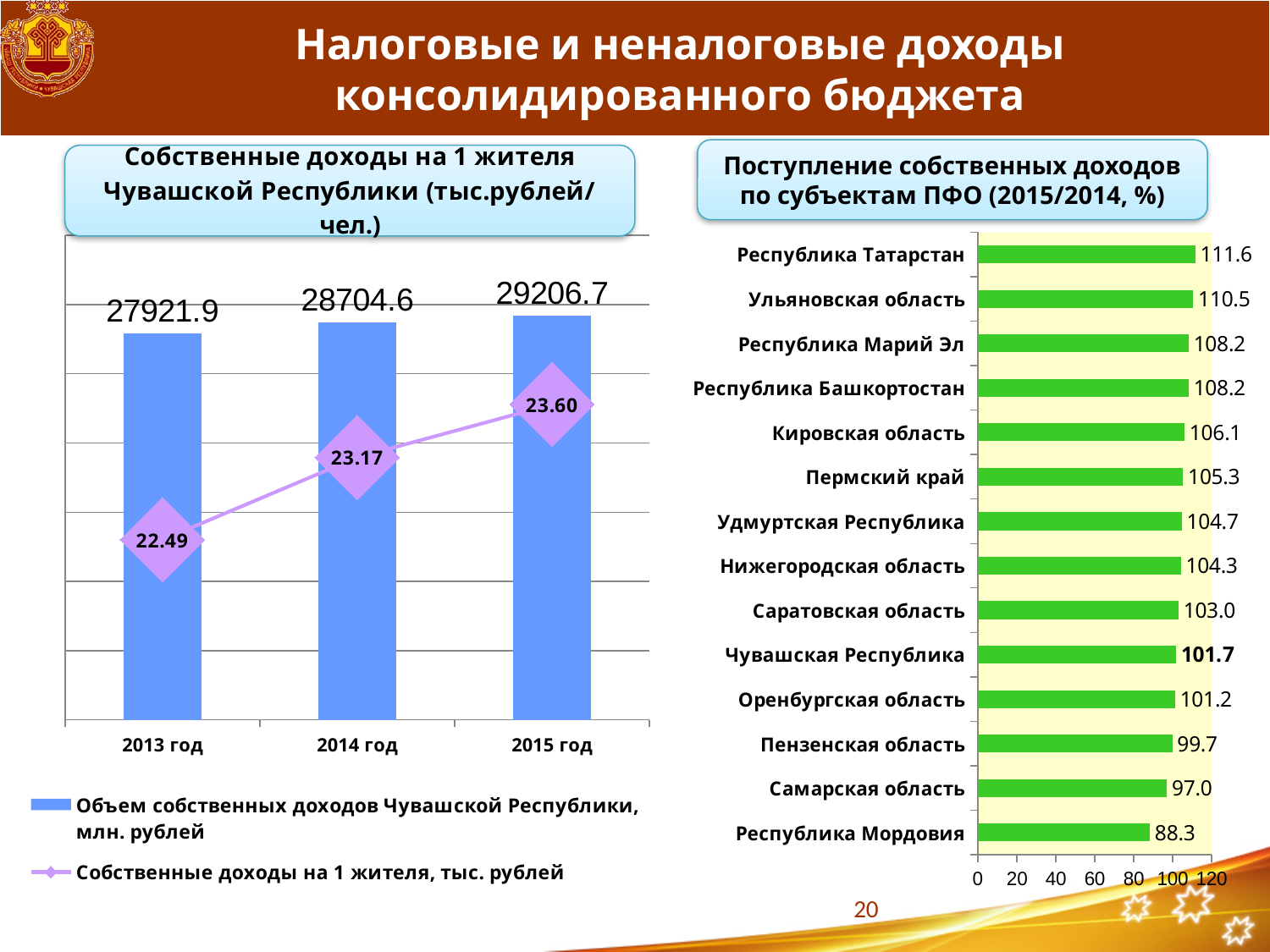
In the right chart (Поступление собственных доходов по субъектам ПФО), which region has the highest value? Республика Татарстан In the right chart, which region has the lowest value? Республика Мордовия In the left chart (Собственные доходы на 1 жителя Чувашской Республики), what is the value of the bar for 2015 год? 29206.7 In the right chart, which is larger: the value for Пензенская область or Самарская область? Пензенская область How many series does the legend of the left chart list? 2 What kind of chart is the right chart? bar chart In the right chart, what is the difference between the values for Республика Татарстан and Республика Мордовия? 23.3 In the left chart, what is the value of the line series (Собственные доходы на 1 жителя, тыс. рублей) for 2013 год? 22.49 In the right chart, how many regions are shown? 14 In the left chart, do the values of the line series rise or fall from 2013 год to 2015 год? rise In the left chart, what is the difference between the bar values for 2015 год and 2014 год? 502.1 In the right chart, what is the value for Чувашская Республика? 101.7